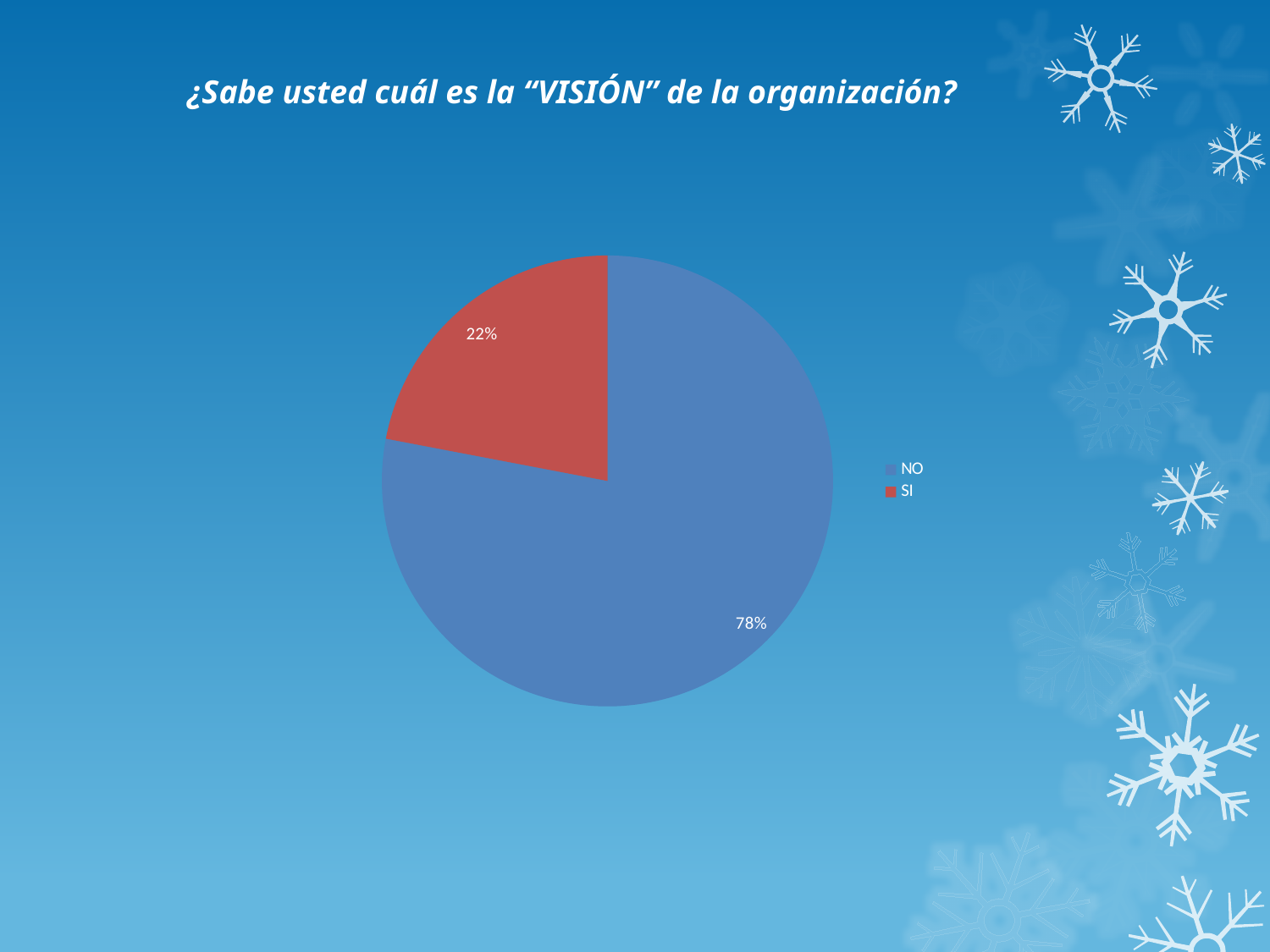
What percentage of the pie is labelled SI? 22% What colour is the SI slice in the pie chart? red Which slice is larger, NO or SI? NO How many slices does the pie chart have? 2 What is the difference in percentage points between the NO and SI slices? 56 What is the title of the slide containing the pie chart? ¿Sabe usted cuál es la “VISIÓN” de la organización? What kind of chart is shown on the slide? pie chart How many entries does the legend list? 2 What share of the pie does the SI slice represent? 22% Which category has the largest share of the pie? NO What percentage of the pie is labelled NO? 78% Which category has the smallest share of the pie? SI